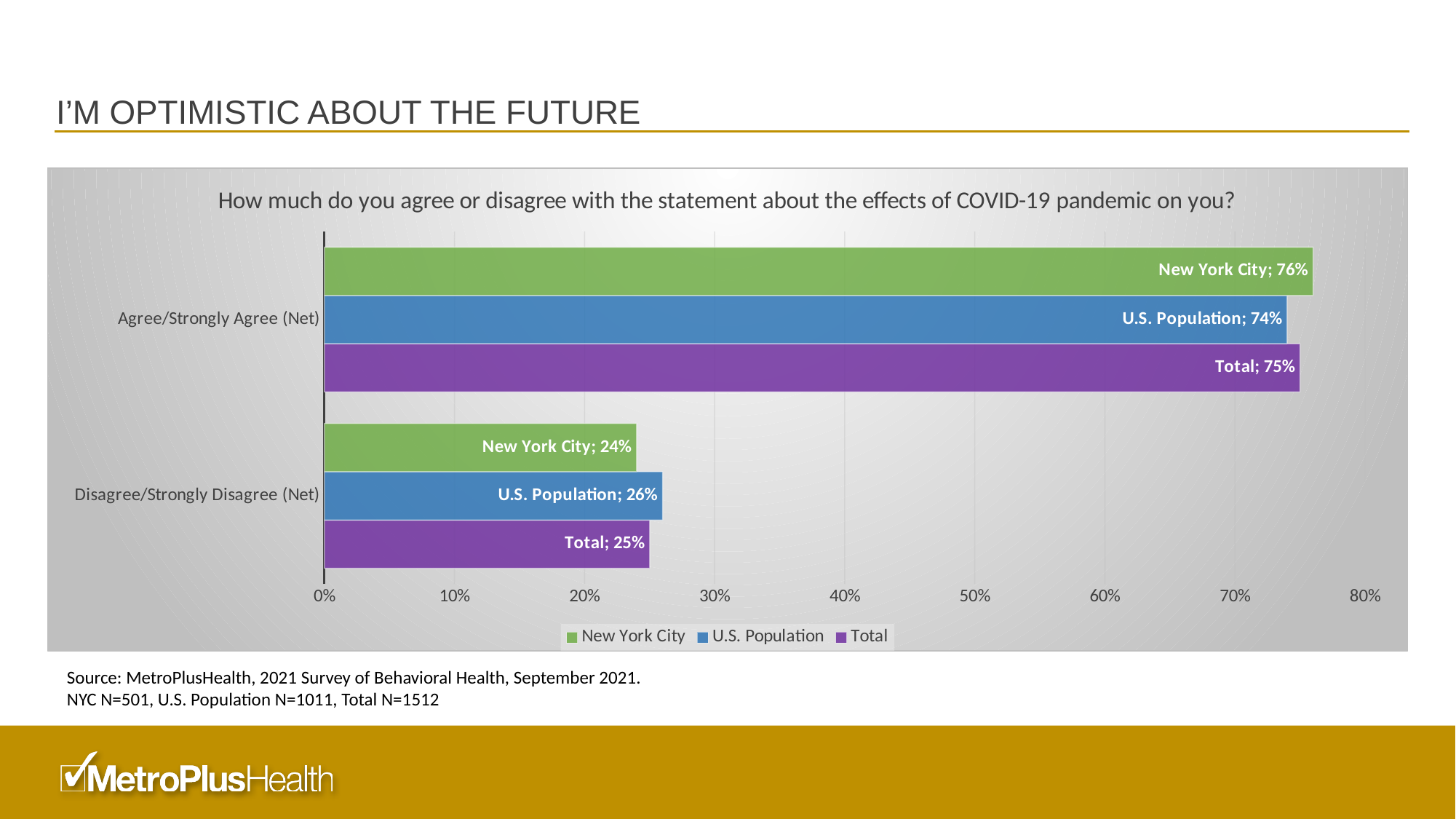
What kind of chart is shown on the slide? Bar chart What colour represents the Total series in the chart? Purple Which is larger: the Total value for Agree/Strongly Agree (Net) or the Total value for Disagree/Strongly Disagree (Net)? Agree/Strongly Agree (Net) Is the U.S. Population value for Disagree/Strongly Disagree (Net) greater or less than 30%? less What is the difference between the New York City and U.S. Population values for Agree/Strongly Agree (Net)? 2% What is the value for New York City in the Agree/Strongly Agree (Net) category? 76% How many series does the legend list? 3 Which series has the highest value in the Agree/Strongly Agree (Net) category? New York City Which series has the lowest value in the Disagree/Strongly Disagree (Net) category? New York City What is the Total value for Agree/Strongly Agree (Net)? 75% What is the value for U.S. Population in the Disagree/Strongly Disagree (Net) category? 26% How many categories are shown on the vertical axis? 2